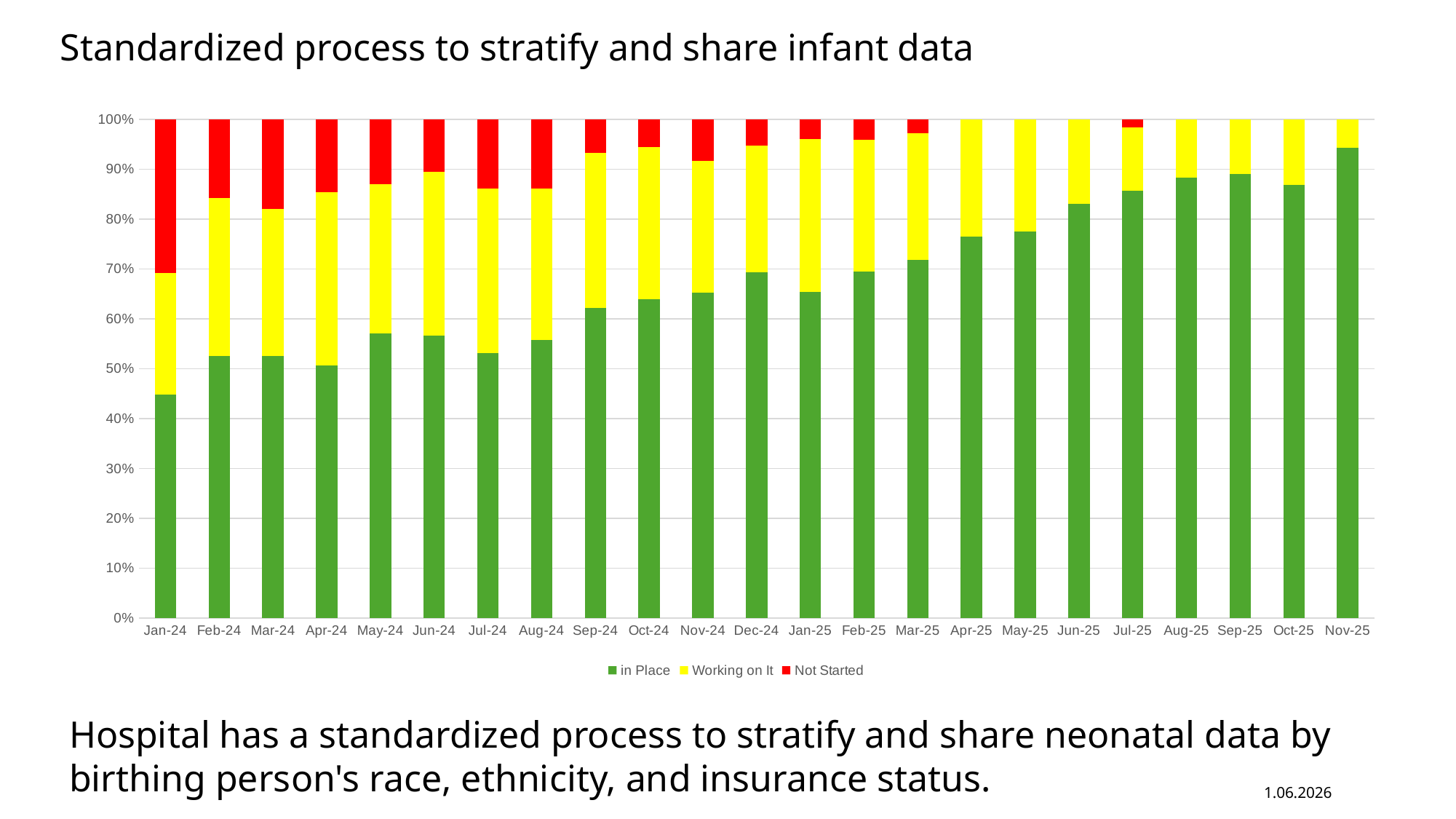
Which month has the lowest 'in Place' share? Jan-24 Does the 'in Place' share generally rise or fall from Jan-24 to Nov-25? rise Is the 'in Place' value for Jan-24 greater or less than 50%? less Which month has a larger 'in Place' share, Dec-24 or Jan-25? Dec-24 Is the 'in Place' value for Jun-25 greater or less than 80%? greater How many months are shown along the x axis? 23 Which month has the largest 'Not Started' share? Jan-24 How many series does the legend list? 3 Which month has the highest 'in Place' share? Nov-25 What colour represents the 'Not Started' series? red Is the 'in Place' value for Nov-25 greater or less than 90%? greater What kind of chart is shown on the slide? stacked bar chart